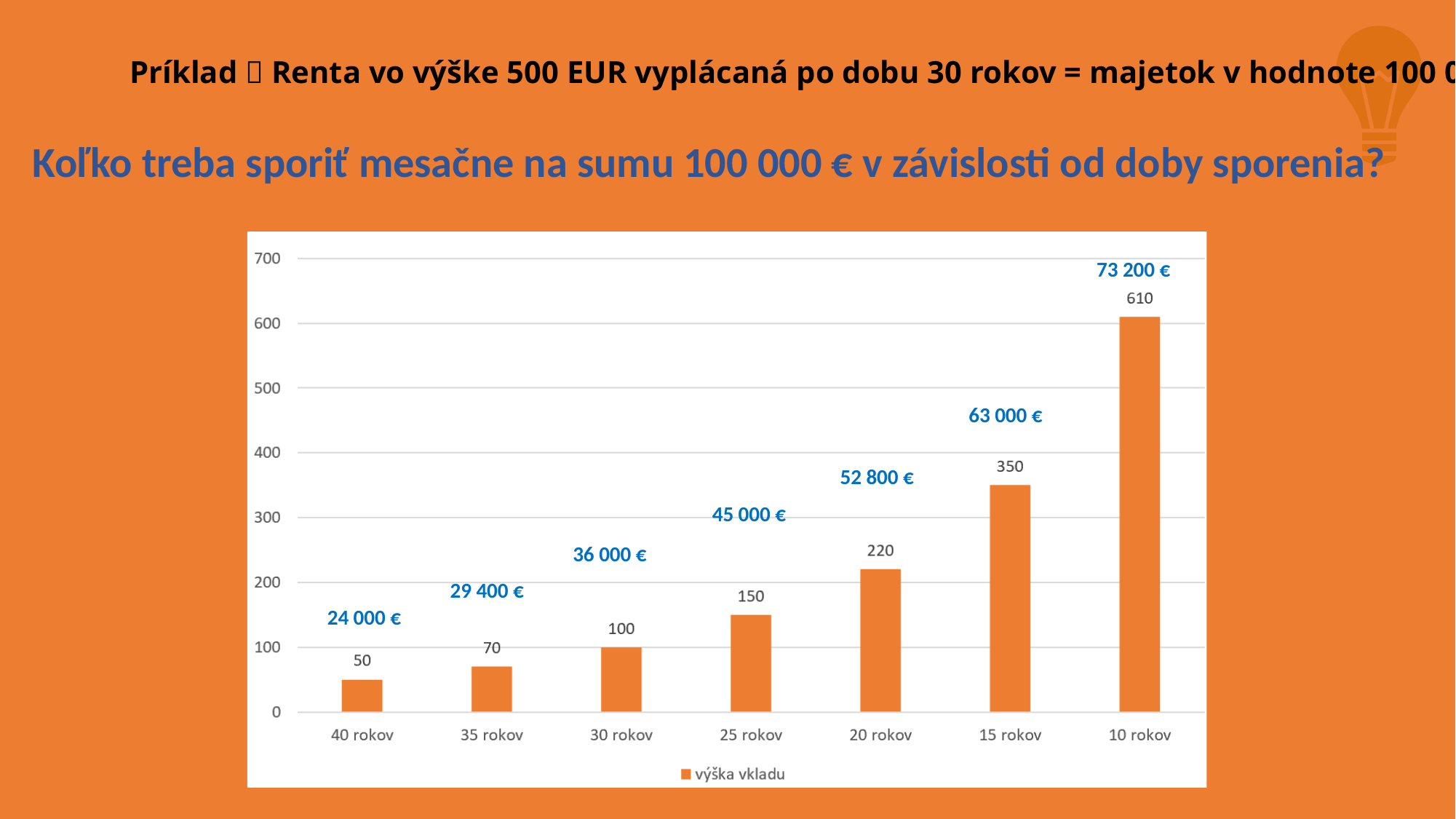
How many categories are shown on the x axis? 7 Which category has the highest value? 10 rokov What is the difference between the values for 15 rokov and 25 rokov? 200 Do the values rise or fall moving from 40 rokov to 10 rokov along the x axis? rise What is the value for 10 rokov? 610 How many series does the legend list? 1 Which is larger, the value for 30 rokov or the value for 35 rokov? 30 rokov Which category has the lowest value? 40 rokov Is the value for 15 rokov greater or less than 300? greater What is the value for 20 rokov? 220 What kind of chart is shown? bar chart What is the value for 40 rokov? 50